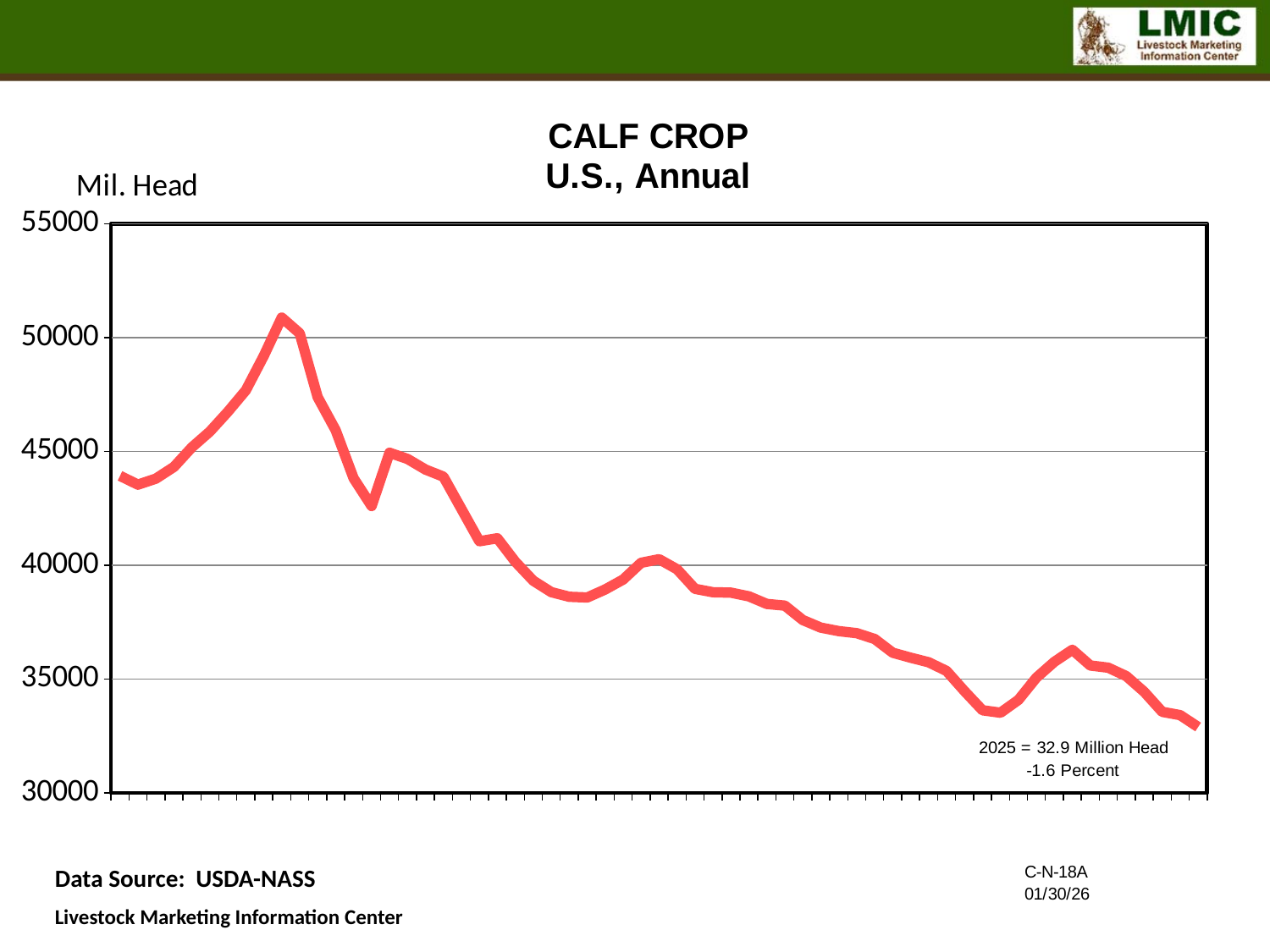
Is the value at the far right end of the calf crop line greater or less than 35000? less According to the annotation on the chart, what was the U.S. calf crop in 2025? 32.9 Million Head What kind of chart is shown on the slide? line chart What is the highest value shown on the vertical axis of the chart? 55000 What is the title of the chart? CALF CROP U.S., Annual What unit label is shown above the vertical axis of the chart? Mil. Head What is the lowest value shown on the vertical axis of the chart? 30000 Overall, does the calf crop line rise or fall from the left side of the chart to the right side? fall Is the highest point of the calf crop line greater or less than 50000? greater According to the annotation on the chart, what was the percent change in the calf crop for 2025? -1.6 Percent Which is larger, the value at the left end of the line or the value at the right end of the line? the left end Is the value at the far left end of the calf crop line greater or less than 45000? less